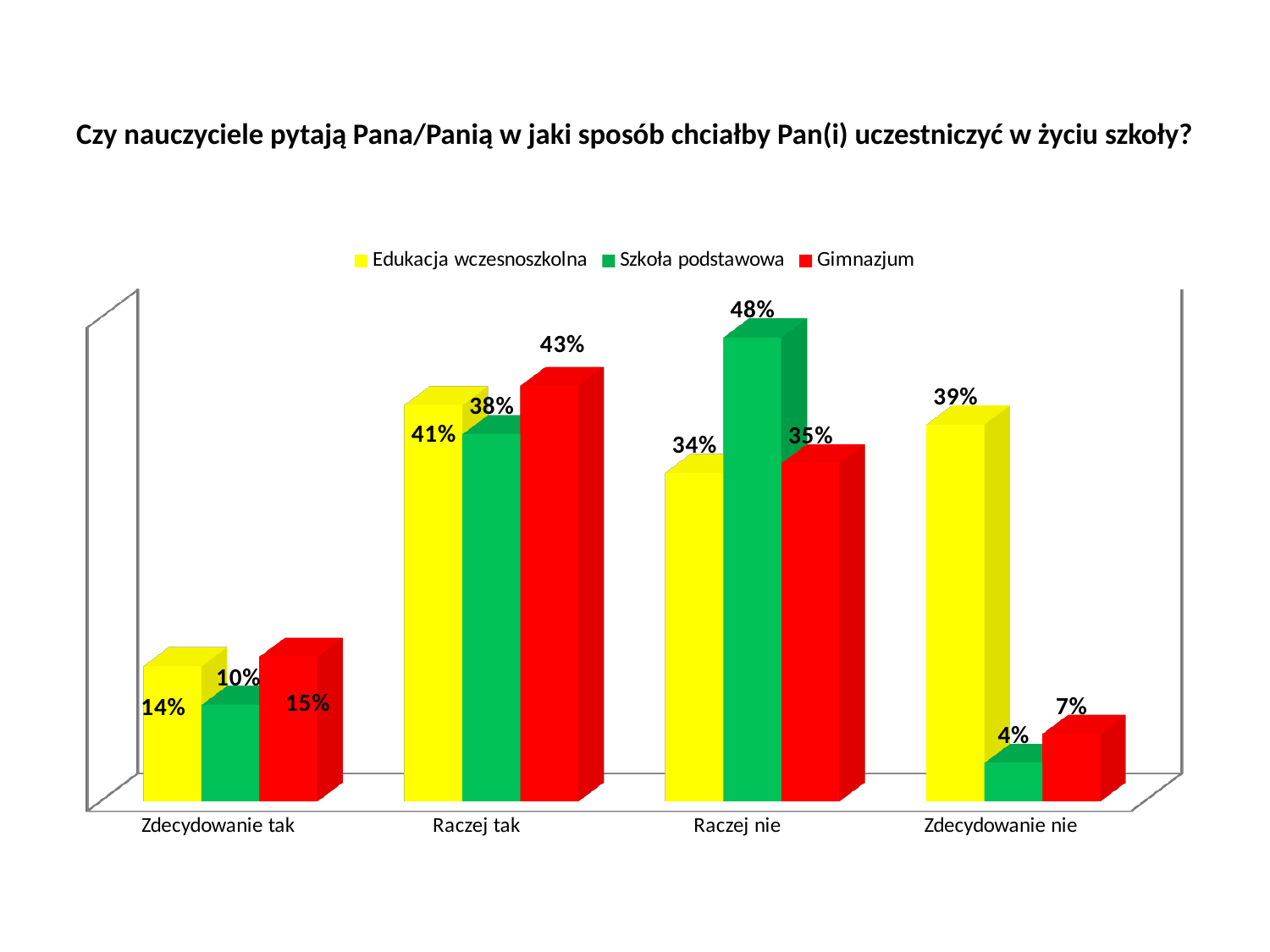
Which category has the lowest value for Szkoła podstawowa? Zdecydowanie nie What is the difference between the Gimnazjum and Edukacja wczesnoszkolna values in the Raczej tak category? 2% How many categories are shown on the x axis? 4 Which category has the highest value for Edukacja wczesnoszkolna? Raczej tak What is the value for Edukacja wczesnoszkolna in the Raczej tak category? 41% What kind of chart is shown on the slide? Bar chart What is the value for Szkoła podstawowa in the Zdecydowanie tak category? 10% What is the value for Gimnazjum in the Zdecydowanie nie category? 7% Which colour represents Gimnazjum in the chart? Red Which is larger in the Zdecydowanie nie category: Edukacja wczesnoszkolna or Gimnazjum? Edukacja wczesnoszkolna What is the value for Szkoła podstawowa in the Raczej nie category? 48% How many series does the legend list? 3